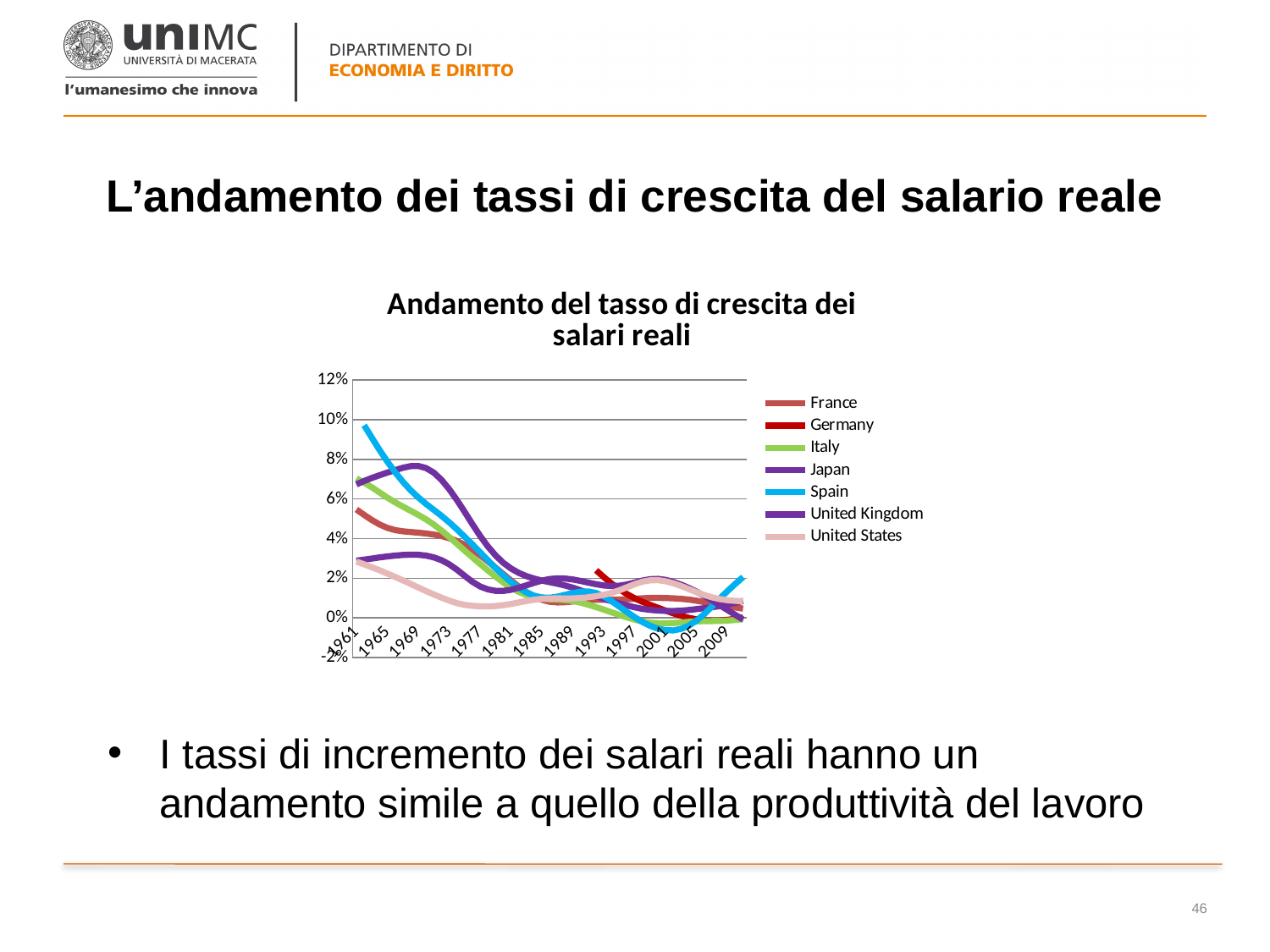
Is the value for Italy in 1961 greater or less than 4%? greater How many year labels are shown on the x axis? 13 How many series does the chart legend list? 7 Is the value for Japan in 1961 greater or less than 6%? greater What is the title of the chart? Andamento del tasso di crescita dei salari reali Does the Spain series rise or fall between 1961 and 2001? Fall Is the value for France in 1961 greater or less than 4%? greater What is the highest value shown on the y axis? 12% What kind of chart is shown on the slide? Line chart